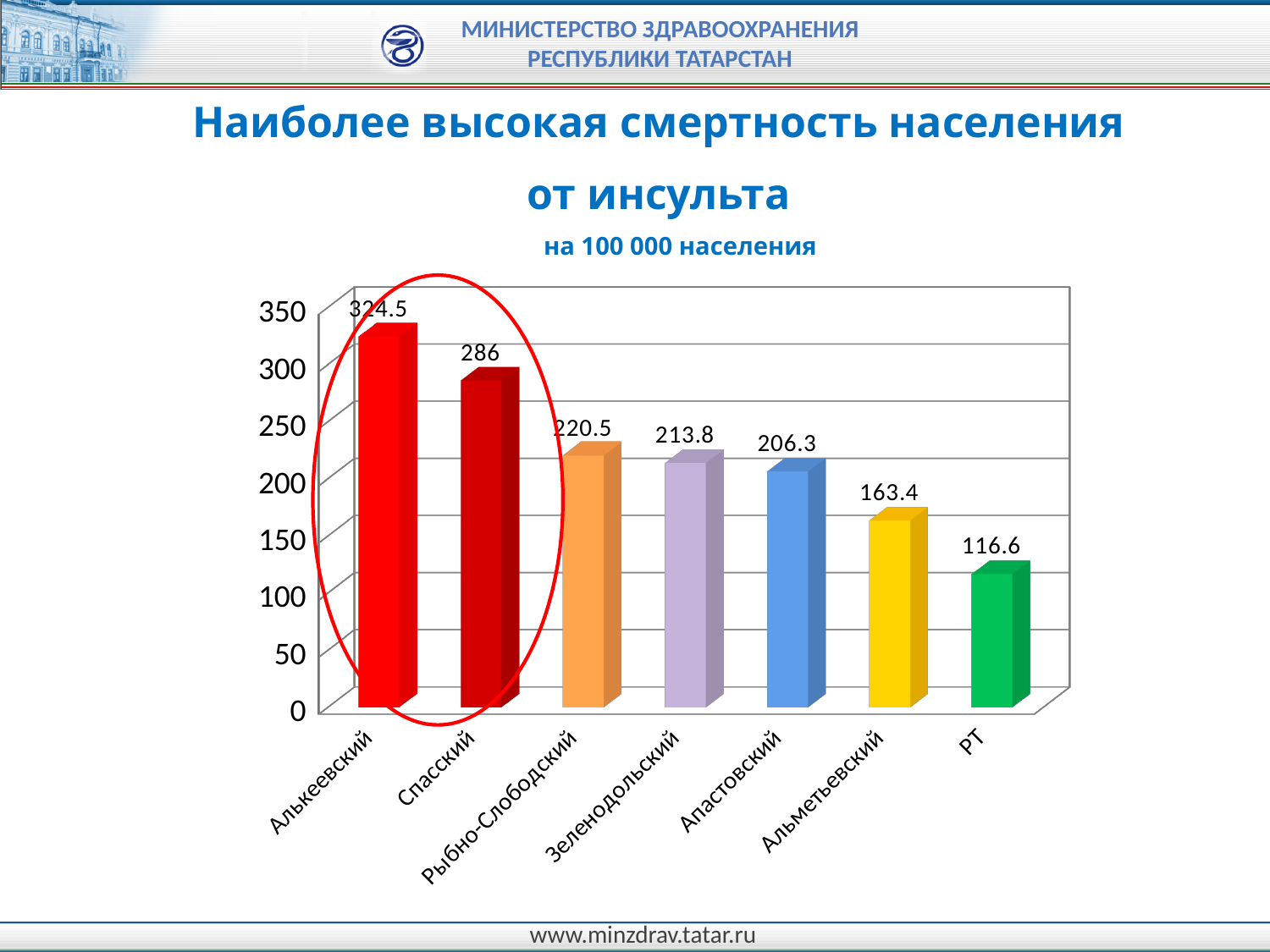
What is the difference between the values for Рыбно-Слободский and РТ? 103.9 What is the stroke mortality value for Спасский? 286 What kind of chart is shown on the slide? bar chart Which category has the lowest value? РТ What is the value shown for РТ? 116.6 Do the values rise or fall from left to right along the x axis? fall What is the value shown for Альметьевский? 163.4 Which is larger, the value for Зеленодольский or the value for Апастовский? Зеленодольский How many categories are shown on the x axis? 7 Is the value for Альметьевский greater or less than 150? greater Which category has the highest value? Алькеевский What is the difference between the values for Алькеевский and Спасский? 38.5